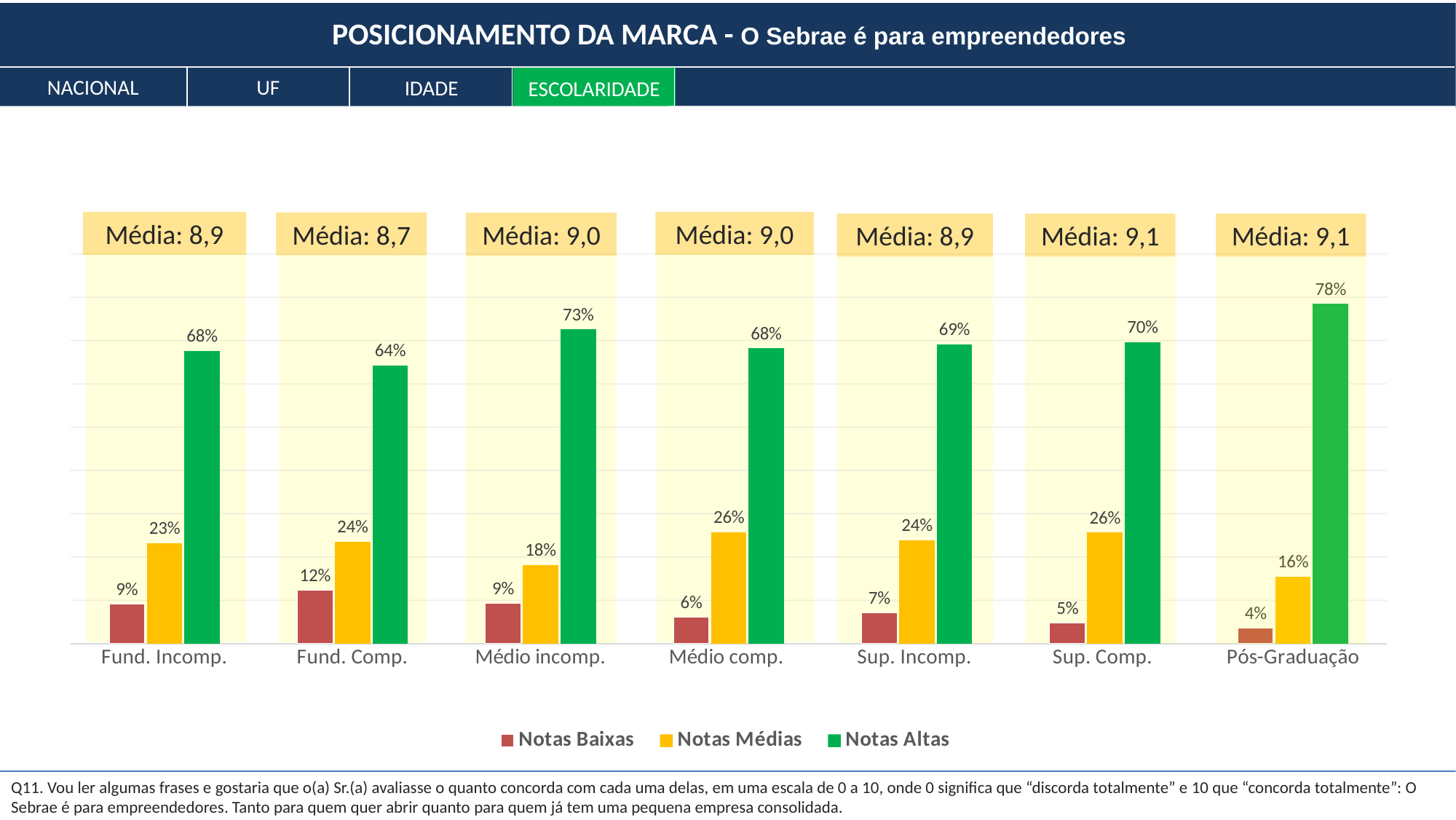
Which category has the highest Notas Altas value? Pós-Graduação What is the Notas Médias value for Médio incomp.? 18% Which category has the lowest Notas Baixas value? Pós-Graduação What is the Notas Baixas value for Fund. Comp.? 12% What kind of chart is shown on the slide? Bar chart What is the difference between the Notas Altas values for Pós-Graduação and Fund. Comp.? 14% What is the Média shown above the Sup. Comp. category? 9,1 Which is larger, the Notas Médias value for Médio comp. or for Sup. Incomp.? Médio comp. How many categories are shown on the x axis? 7 How many series does the legend list? 3 Which colour represents the Notas Altas series? Green What is the Notas Altas value for Pós-Graduação? 78%